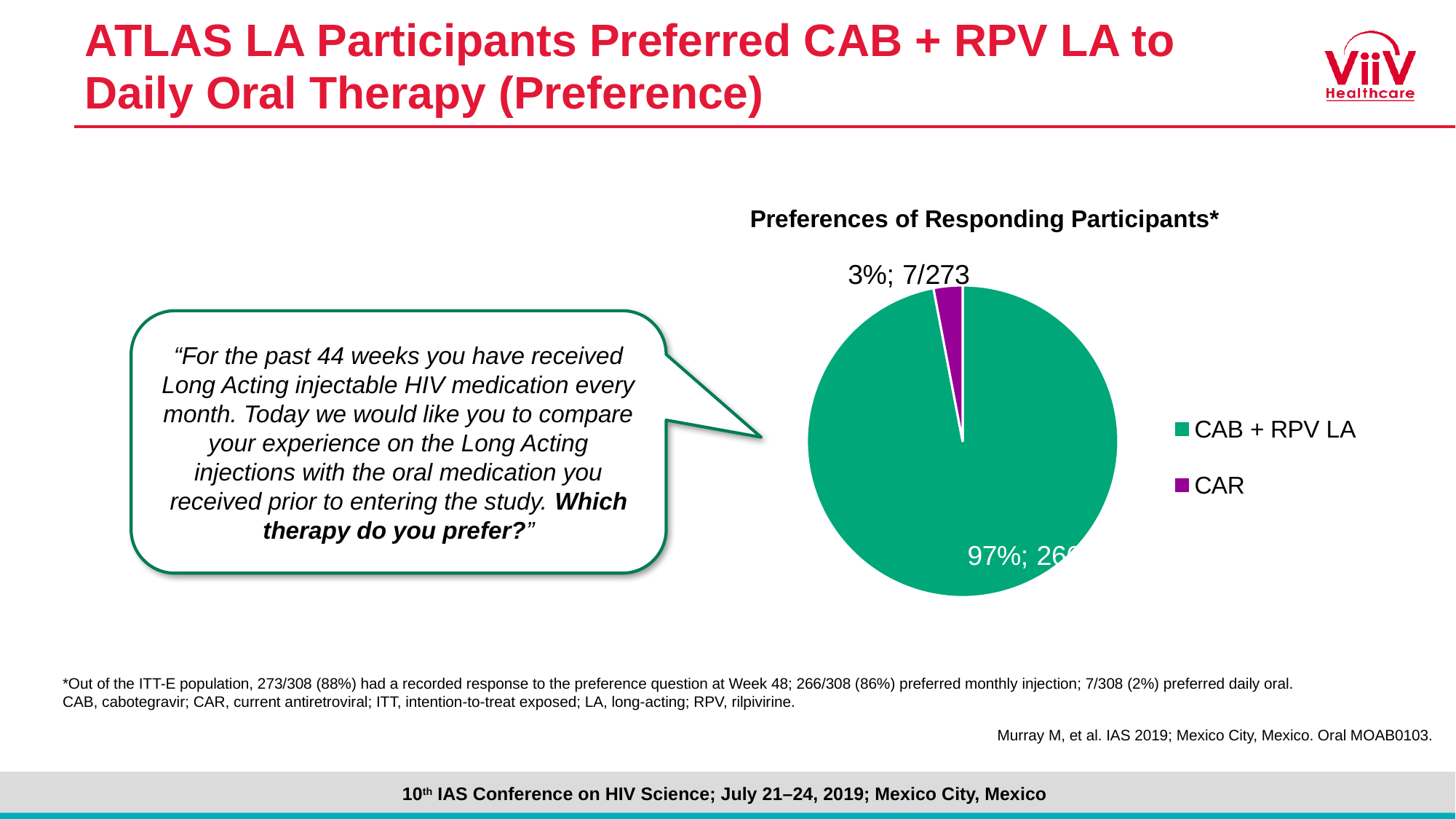
What percentage of responding participants preferred CAR? 3% Which preference has the largest slice of the pie chart? CAB + RPV LA What is the title of the pie chart? Preferences of Responding Participants* How many slices does the pie chart have? 2 Which slice is larger, CAB + RPV LA or CAR? CAB + RPV LA What is the difference in percentage points between the CAB + RPV LA share and the CAR share? 94 percentage points What percentage of responding participants preferred CAB + RPV LA? 97% How many entries does the legend of the pie chart list? 2 Which preference has the smallest slice of the pie chart? CAR What count is shown on the data label for the CAR slice? 7/273 What colour is the CAR slice in the pie chart? Purple What kind of chart is shown on the slide? Pie chart